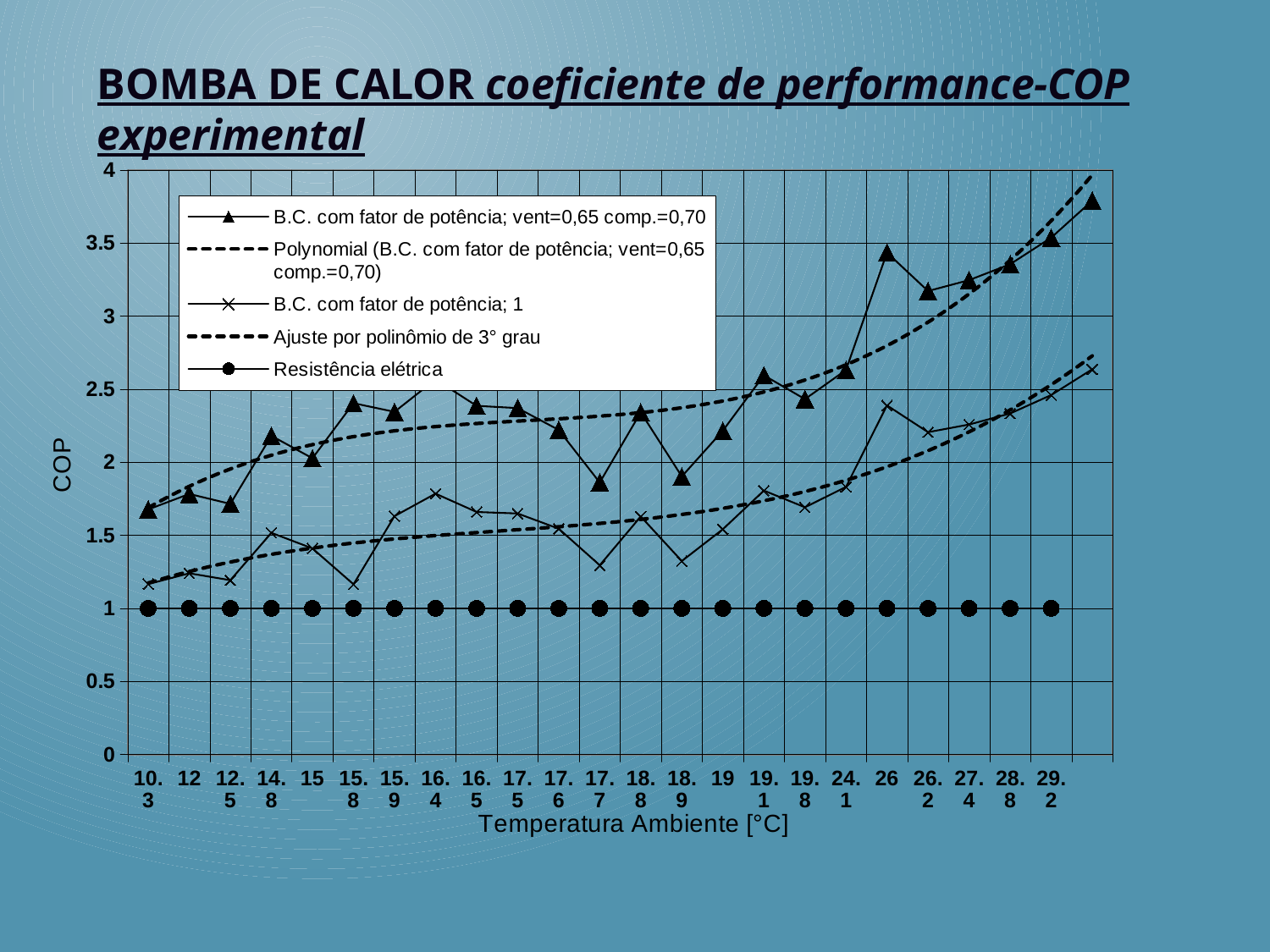
How many temperature categories are shown on the x axis? 23 How many series does the legend list? 5 Is the value for 'B.C. com fator de potência; vent=0,65 comp.=0,70' at 26 °C greater or less than 3? greater What kind of chart is shown on the slide? line chart What is the label of the vertical axis? COP Is the value for 'B.C. com fator de potência; 1' at 17.7 °C greater or less than 1.5? less Is the value for 'B.C. com fator de potência; vent=0,65 comp.=0,70' at 10.3 °C greater or less than 2? less What is the value of the 'Resistência elétrica' series at 29.2 °C? 1 At 26 °C, which series has the larger value: 'B.C. com fator de potência; vent=0,65 comp.=0,70' or 'B.C. com fator de potência; 1'? B.C. com fator de potência; vent=0,65 comp.=0,70 What is the value of the 'Resistência elétrica' series at 19 °C? 1